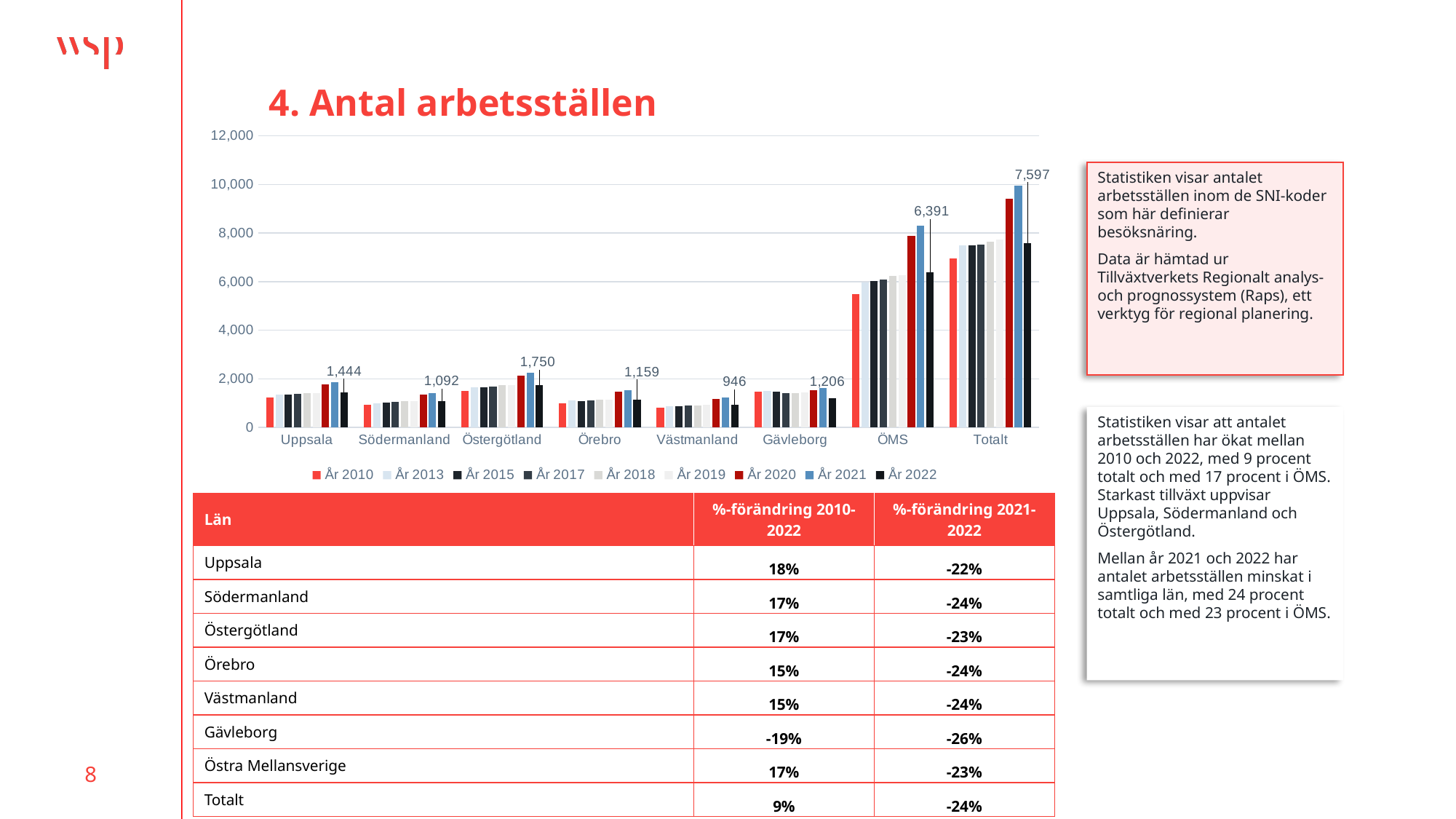
What is the value for Västmanland in the År 2022 series? 946 What is the value for ÖMS in the År 2022 series? 6,391 What kind of chart is shown on the slide? Bar chart What is the value for Uppsala in the År 2022 series? 1,444 How many categories are shown on the x axis of the chart? 8 Among the six län (excluding ÖMS and Totalt), which has the highest År 2022 value? Östergötland Which has the larger År 2022 value, Örebro or Gävleborg? Gävleborg What is the difference between the År 2022 values for Östergötland and Uppsala? 306 Is the År 2021 value for Totalt greater or less than 8,000? greater How many series does the chart legend list? 9 What is the value for Totalt in the År 2022 series? 7,597 Among the six län (excluding ÖMS and Totalt), which has the lowest År 2022 value? Västmanland